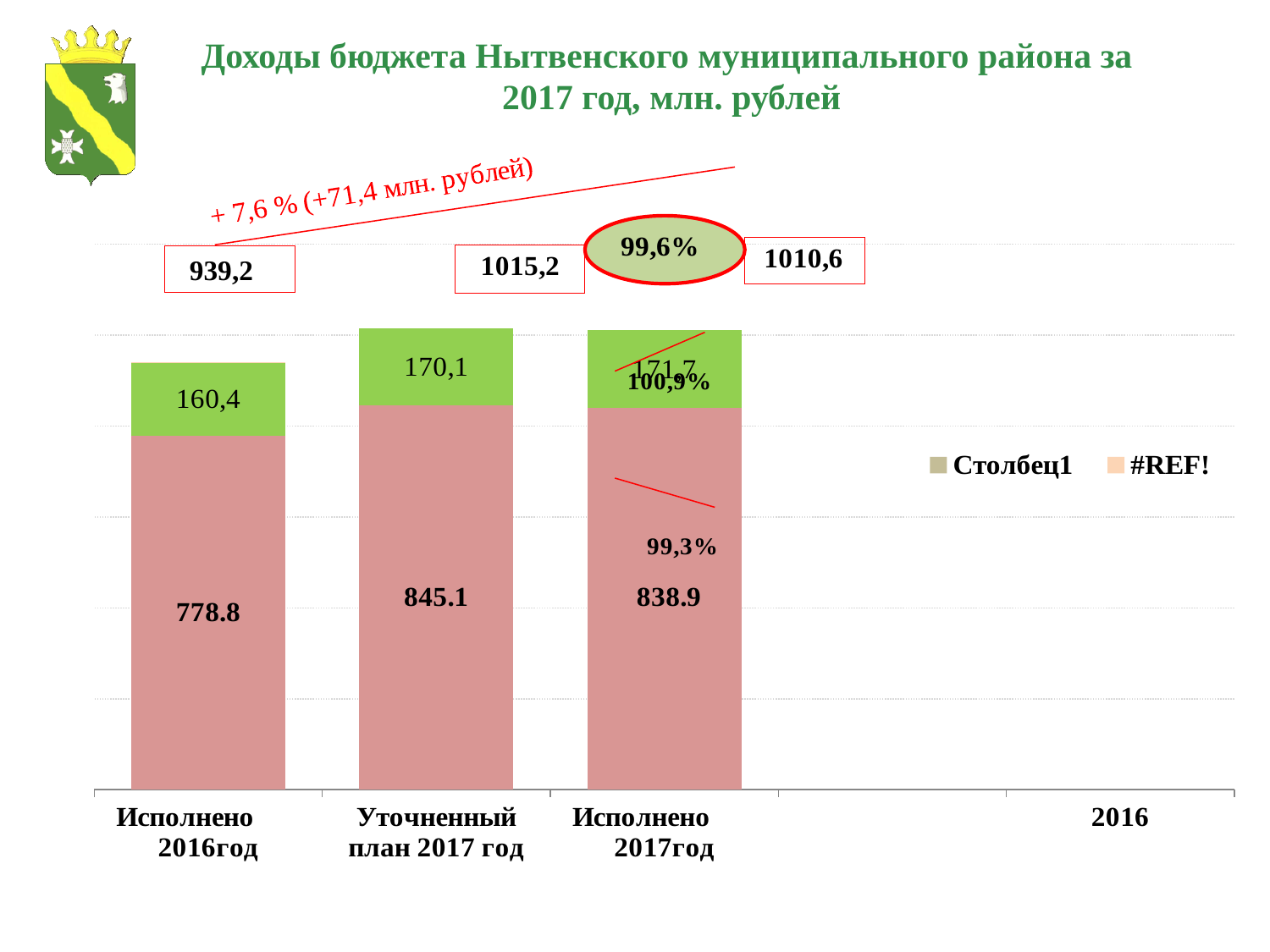
What is the total shown above the bar for "Уточненный план 2017 год"? 1015,2 What is the value of the upper (green) segment for "Уточненный план 2017 год"? 170,1 What is the value of the lower (pink) segment for "Исполнено 2017год"? 838.9 Which is larger, the pink segment for "Уточненный план 2017 год" or the pink segment for "Исполнено 2017год"? Уточненный план 2017 год Which category has the highest total? Уточненный план 2017 год What percentage is shown in the red-outlined oval above the "Исполнено 2017год" bar? 99,6% How many bars are plotted in the chart? 3 Which category has the lowest total? Исполнено 2016год What is the value of the upper (green) segment for "Исполнено 2016год"? 160,4 What type of chart is shown on the slide? stacked bar chart What is the total shown above the bar for "Исполнено 2016год"? 939,2 What is the value of the lower (pink) segment for "Исполнено 2016год"? 778.8